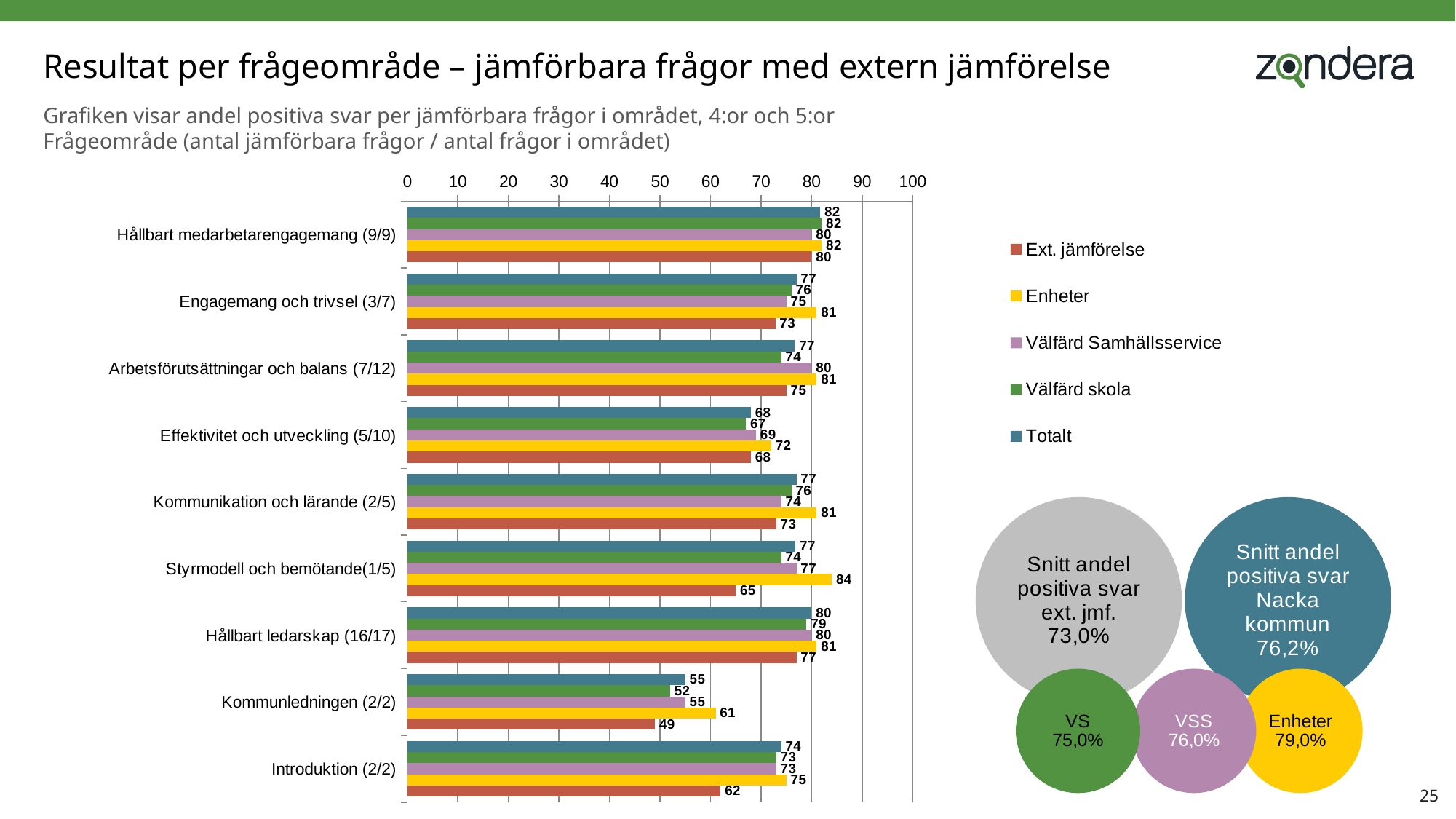
What is the Ext. jämförelse value for Kommunledningen (2/2)? 49 What kind of chart is shown on the slide? Bar chart What is the Enheter value for Styrmodell och bemötande(1/5)? 84 Which category has the highest Enheter value? Styrmodell och bemötande(1/5) Which category has the lowest Totalt value? Kommunledningen (2/2) What is the Totalt value for Introduktion (2/2)? 74 What is the Välfärd Samhällsservice value for Arbetsförutsättningar och balans (7/12)? 80 What is the difference between the Enheter and Ext. jämförelse values for Styrmodell och bemötande(1/5)? 19 How many series does the legend list? 5 How many categories are shown on the chart? 9 For Introduktion (2/2), which is larger: the Enheter value or the Ext. jämförelse value? Enheter Which colour represents the Enheter series in the chart? Yellow